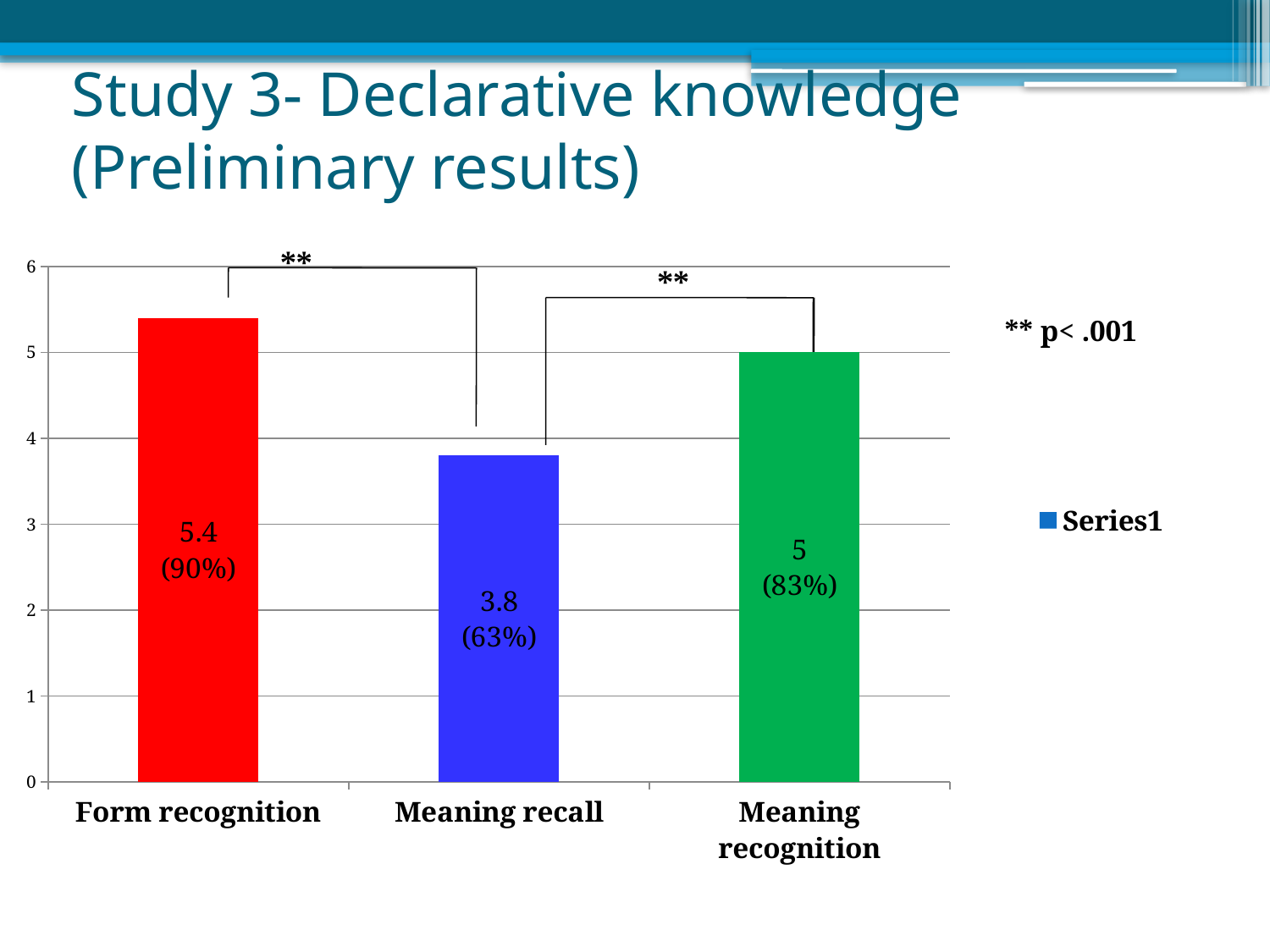
What is the value for Form recognition? 5.4 What is the value for Meaning recognition? 5 Is the value for Meaning recall greater or less than 4? less What is the value for Meaning recall? 3.8 Which category has the highest value? Form recognition What kind of chart is shown on the slide? bar chart What series name does the legend list? Series1 Which category has the lowest value? Meaning recall Which is larger, the value for Meaning recognition or the value for Meaning recall? Meaning recognition How many categories are shown on the x axis? 3 What is the difference between the values for Form recognition and Meaning recall? 1.6 What percentage is shown for Meaning recall? 63%